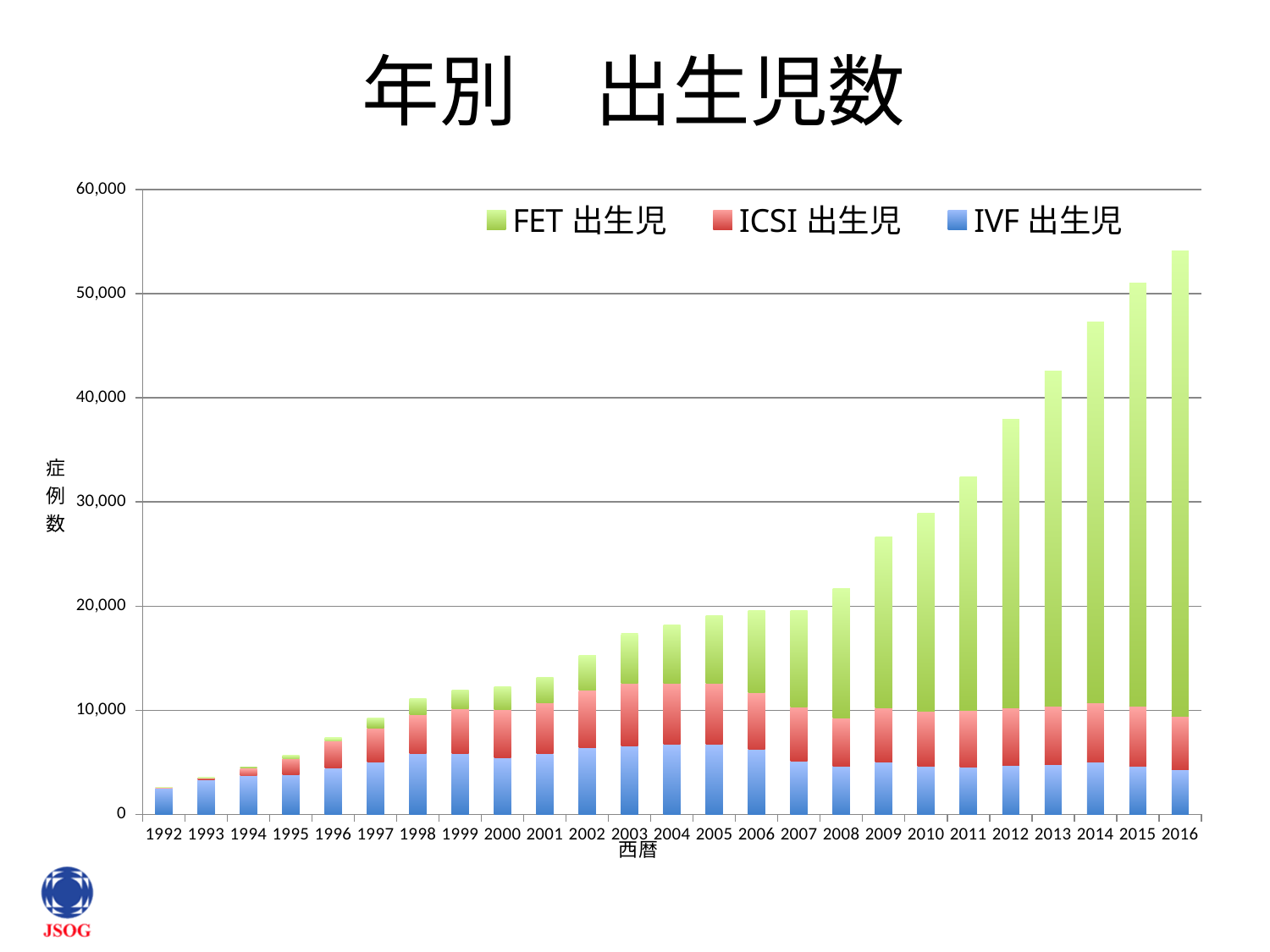
What kind of chart is shown on the slide? Stacked bar chart Is the total value for 2016 greater or less than 50,000? greater How many years are shown along the x axis of the chart? 25 Is the total value for 2008 greater or less than 20,000? greater Is the total value for 2011 greater or less than 30,000? greater Which year has the lowest total number of births in the chart? 1992 How many series does the chart's legend list? 3 Do the total bar heights generally rise or fall from 1992 to 2016? Rise What is the title of the chart on the slide? 年別 出生児数 Which year has the highest total number of births in the chart? 2016 Which year has a larger total bar, 2015 or 2016? 2016